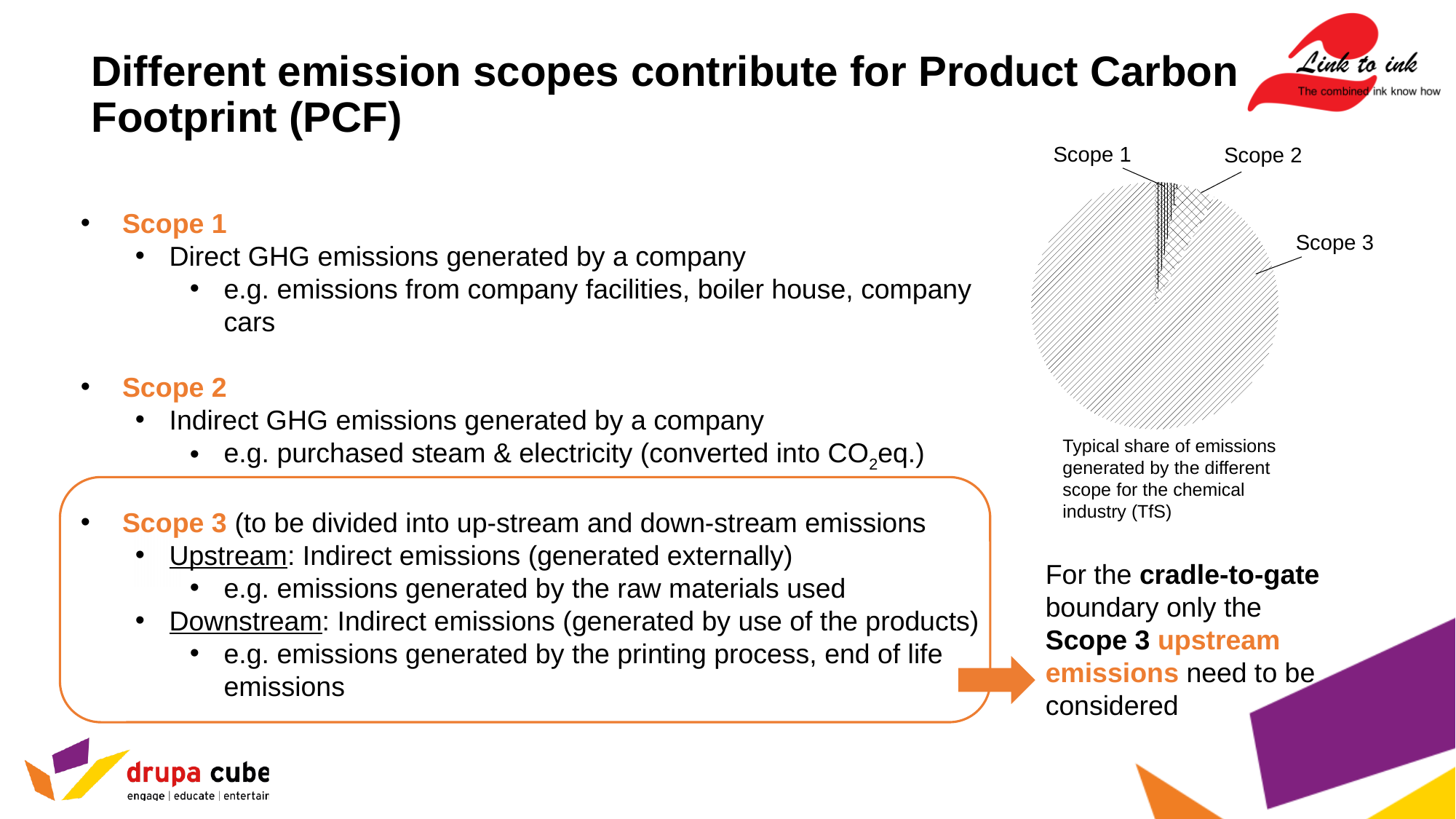
Does Scope 3 account for more or less than half of the pie chart? more In the pie chart, which slice is larger: Scope 2 or Scope 1? Scope 2 Which scope has the largest share of emissions in the pie chart? Scope 3 Which scope has the smallest share of emissions in the pie chart? Scope 1 In the pie chart, which slice is larger: Scope 3 or Scope 2? Scope 3 What kind of chart is shown on the slide? pie chart What are the labels of the three slices in the pie chart? Scope 1, Scope 2, Scope 3 According to the caption, which industry does the pie chart's typical share of emissions refer to? the chemical industry (TfS) How many slices does the pie chart have? 3